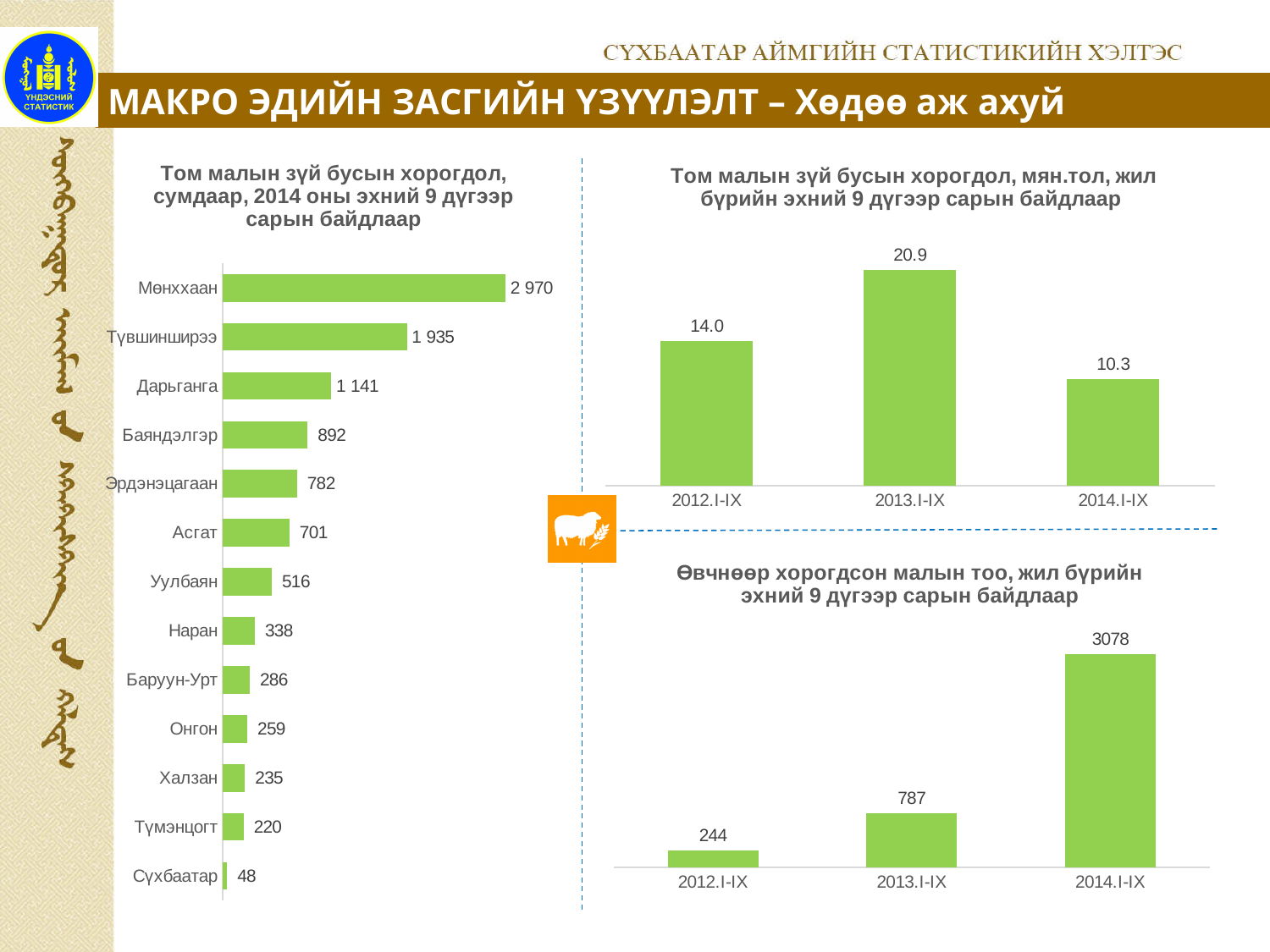
In the bottom right chart (Өвчнөөр хорогдсон малын тоо), do the values rise or fall from 2012.I-IX to 2014.I-IX? rise In the left chart (Том малын зүй бусын хорогдол, сумдаар), what is the value for Халзан? 235 In the left chart (Том малын зүй бусын хорогдол, сумдаар), which is larger, Баяндэлгэр or Эрдэнэцагаан? Баяндэлгэр In the top right chart (Том малын зүй бусын хорогдол, мян.тол), which year has the lowest value? 2014.I-IX In the left chart (Том малын зүй бусын хорогдол, сумдаар), what is the value for Мөнххаан? 2 970 In the bottom right chart (Өвчнөөр хорогдсон малын тоо), what is the value for 2014.I-IX? 3078 In the left chart (Том малын зүй бусын хорогдол, сумдаар), how many soums are shown? 13 In the top right chart (Том малын зүй бусын хорогдол, мян.тол), what is the value for 2013.I-IX? 20.9 What type of chart is the left chart (Том малын зүй бусын хорогдол, сумдаар)? bar chart In the left chart (Том малын зүй бусын хорогдол, сумдаар), which soum has the lowest value? Сүхбаатар In the top right chart (Том малын зүй бусын хорогдол, мян.тол), what is the difference between 2013.I-IX and 2012.I-IX? 6.9 In the left chart (Том малын зүй бусын хорогдол, сумдаар), what is the difference between Түвшинширээ and Дарьганга? 794